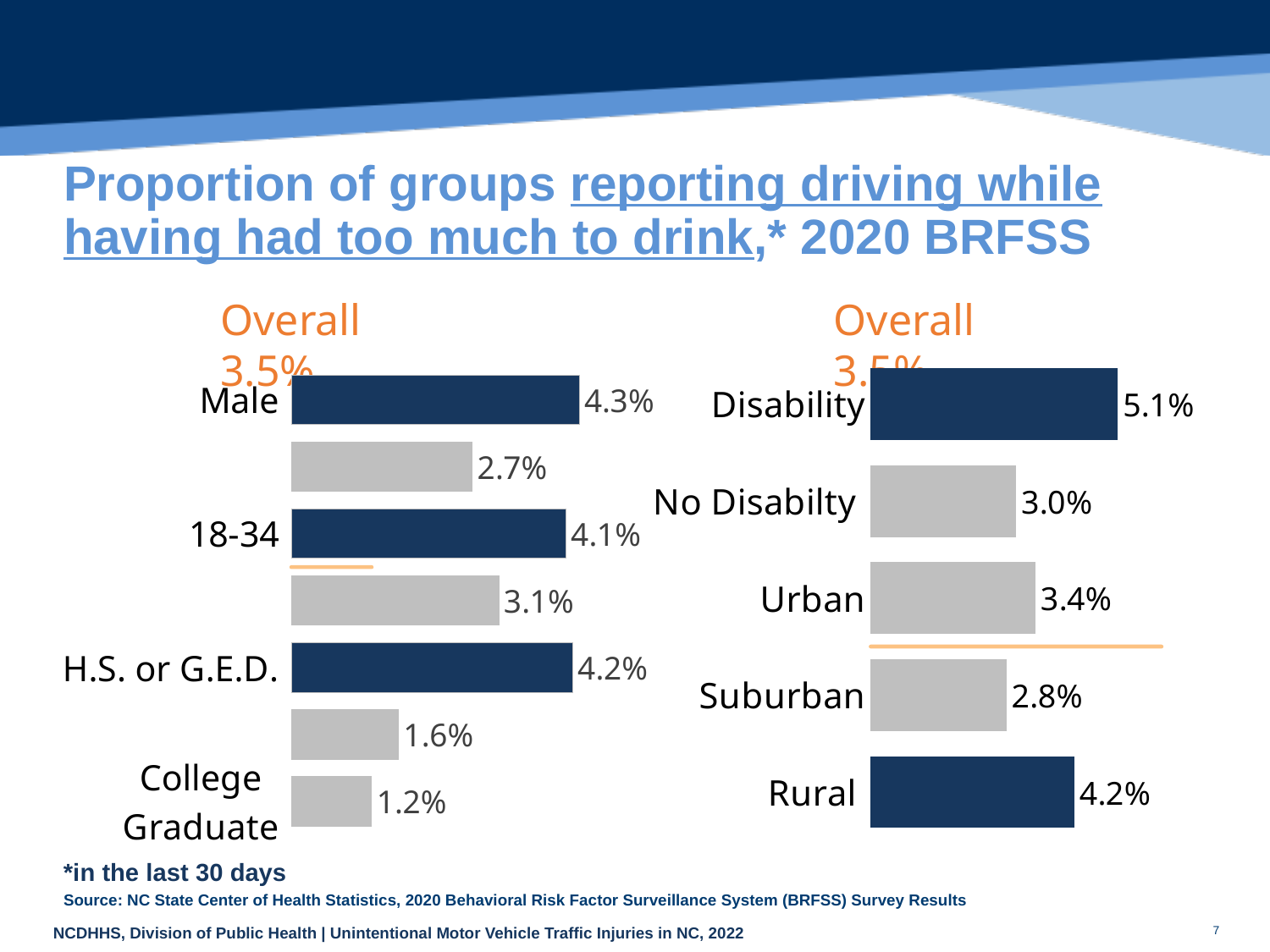
In the right-hand chart, which is larger, the value for Urban or the value for Rural? Rural In the left-hand chart, what is the value for Male? 4.3% What overall proportion is shown above each chart? 3.5% In the right-hand chart, what is the value for Disability? 5.1% What kind of chart is used on this slide? Bar chart In the right-hand chart, which category has the lowest value? Suburban In the right-hand chart, what is the difference between the values for Disability and No Disabilty? 2.1% How many categories are shown in the right-hand chart? 5 In the left-hand chart, what is the value for H.S. or G.E.D.? 4.2% In the right-hand chart, what is the value for Rural? 4.2% In the left-hand chart, what is the value for College Graduate? 1.2% In the right-hand chart, which category has the highest value? Disability